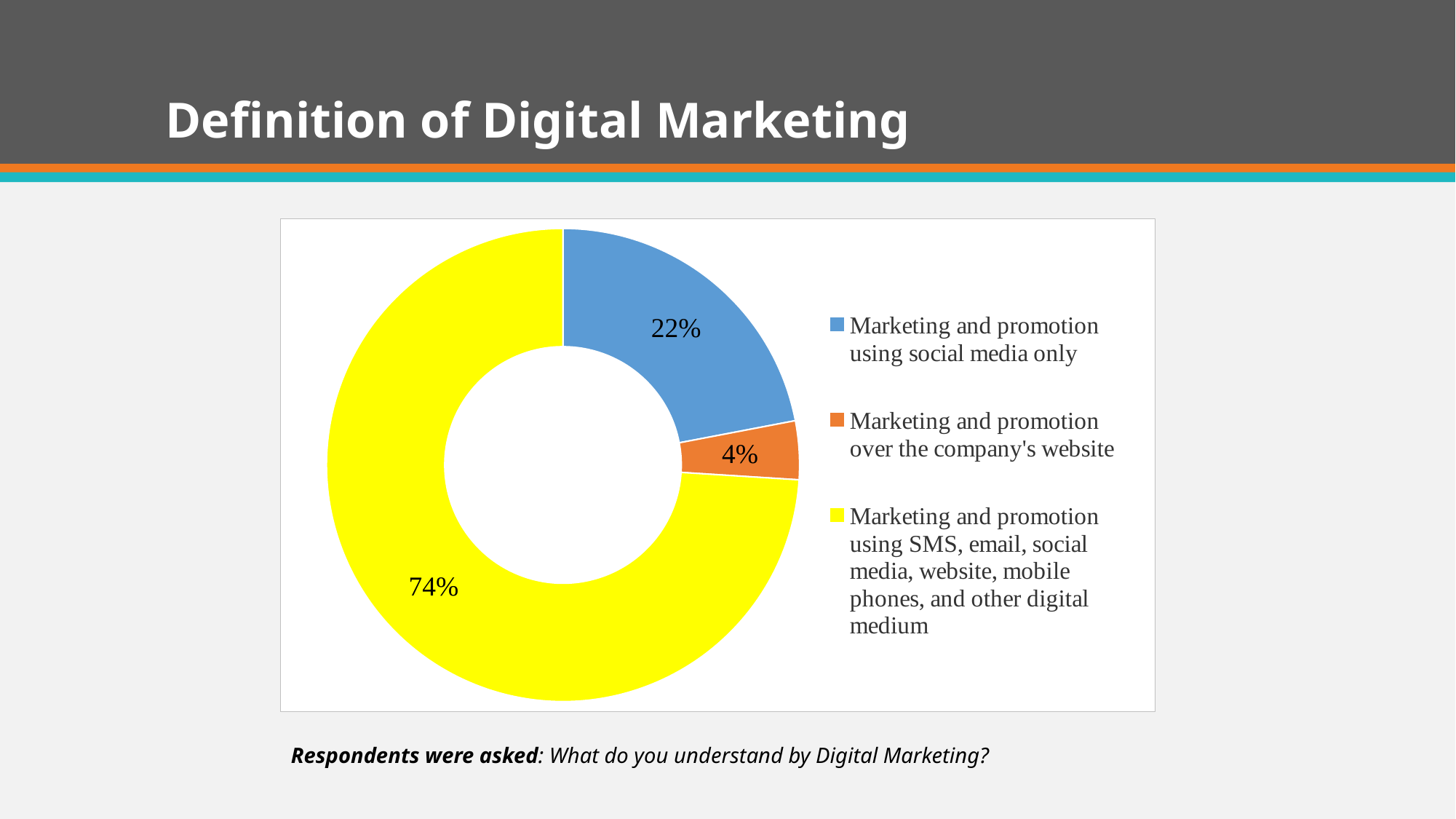
Which definition received the largest share of respondents? Marketing and promotion using SMS, email, social media, website, mobile phones, and other digital medium What is the difference in percentage points between the largest slice and the 'social media only' slice? 52 What colour is the slice for 'Marketing and promotion over the company's website'? Orange What is the difference in percentage points between the 'social media only' slice and the 'company's website' slice? 18 How many slices does the chart have? 3 What question were respondents asked, according to the text below the chart? What do you understand by Digital Marketing? Which definition received the smallest share of respondents? Marketing and promotion over the company's website What share of respondents defined digital marketing as marketing and promotion using SMS, email, social media, website, mobile phones, and other digital medium? 74% Which is larger: the share for 'social media only' or the share for 'over the company's website'? Marketing and promotion using social media only What kind of chart is shown on the slide? Doughnut chart What share of respondents defined digital marketing as marketing and promotion using social media only? 22% What share of respondents defined digital marketing as marketing and promotion over the company's website? 4%